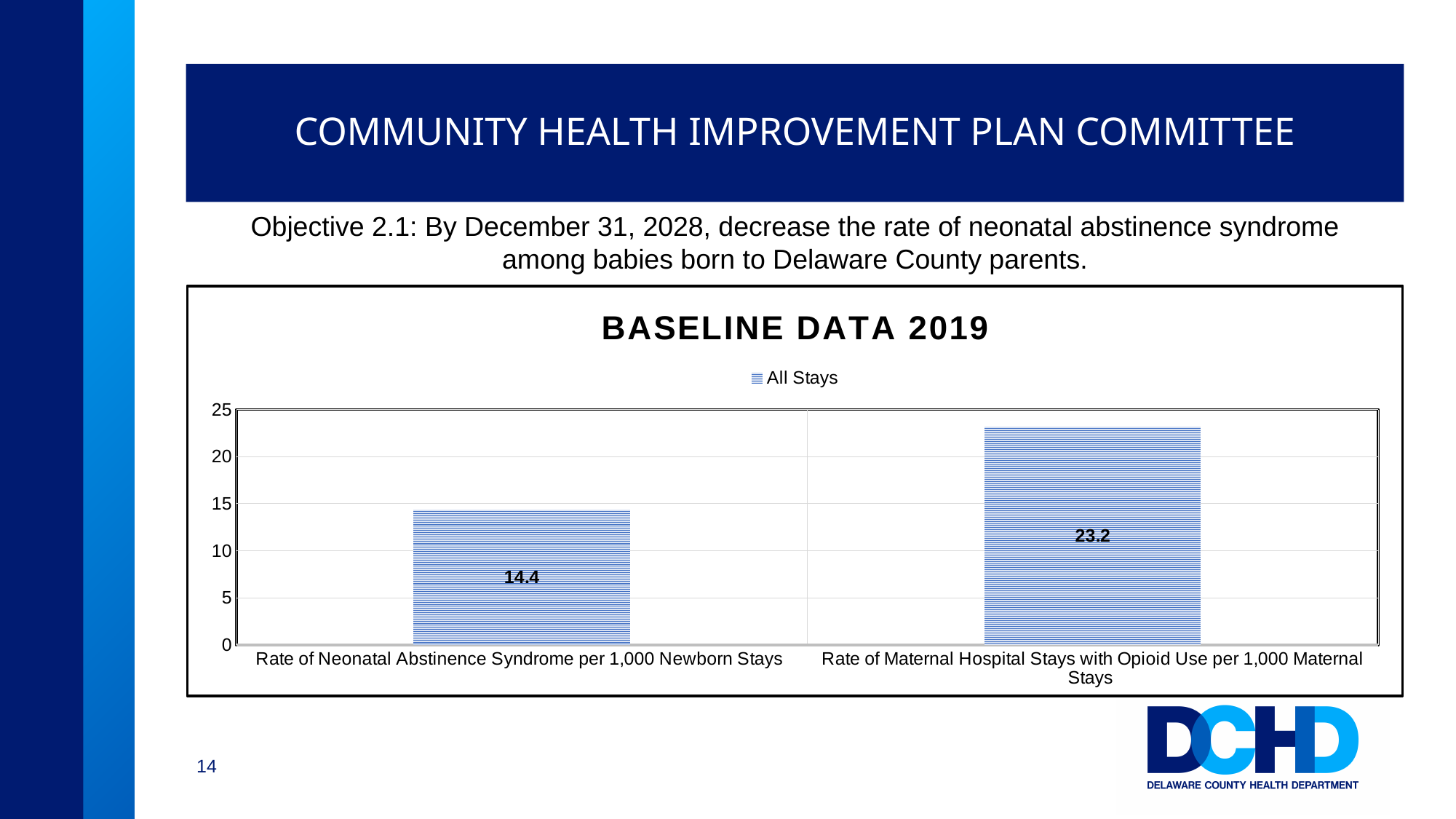
What is the value for Rate of Neonatal Abstinence Syndrome per 1,000 Newborn Stays? 14.4 What kind of chart is shown on the slide? Bar chart What is the value for Rate of Maternal Hospital Stays with Opioid Use per 1,000 Maternal Stays? 23.2 What is the difference between the Rate of Maternal Hospital Stays with Opioid Use per 1,000 Maternal Stays and the Rate of Neonatal Abstinence Syndrome per 1,000 Newborn Stays? 8.8 Which category has the highest value? Rate of Maternal Hospital Stays with Opioid Use per 1,000 Maternal Stays Which is larger: the Rate of Neonatal Abstinence Syndrome per 1,000 Newborn Stays or the Rate of Maternal Hospital Stays with Opioid Use per 1,000 Maternal Stays? Rate of Maternal Hospital Stays with Opioid Use per 1,000 Maternal Stays How many series does the legend list? 1 Which category has the lowest value? Rate of Neonatal Abstinence Syndrome per 1,000 Newborn Stays Is the value for Rate of Maternal Hospital Stays with Opioid Use per 1,000 Maternal Stays greater or less than 20? greater What is the title of the chart? BASELINE DATA 2019 Is the value for Rate of Neonatal Abstinence Syndrome per 1,000 Newborn Stays greater or less than 15? less How many categories are shown on the x axis? 2